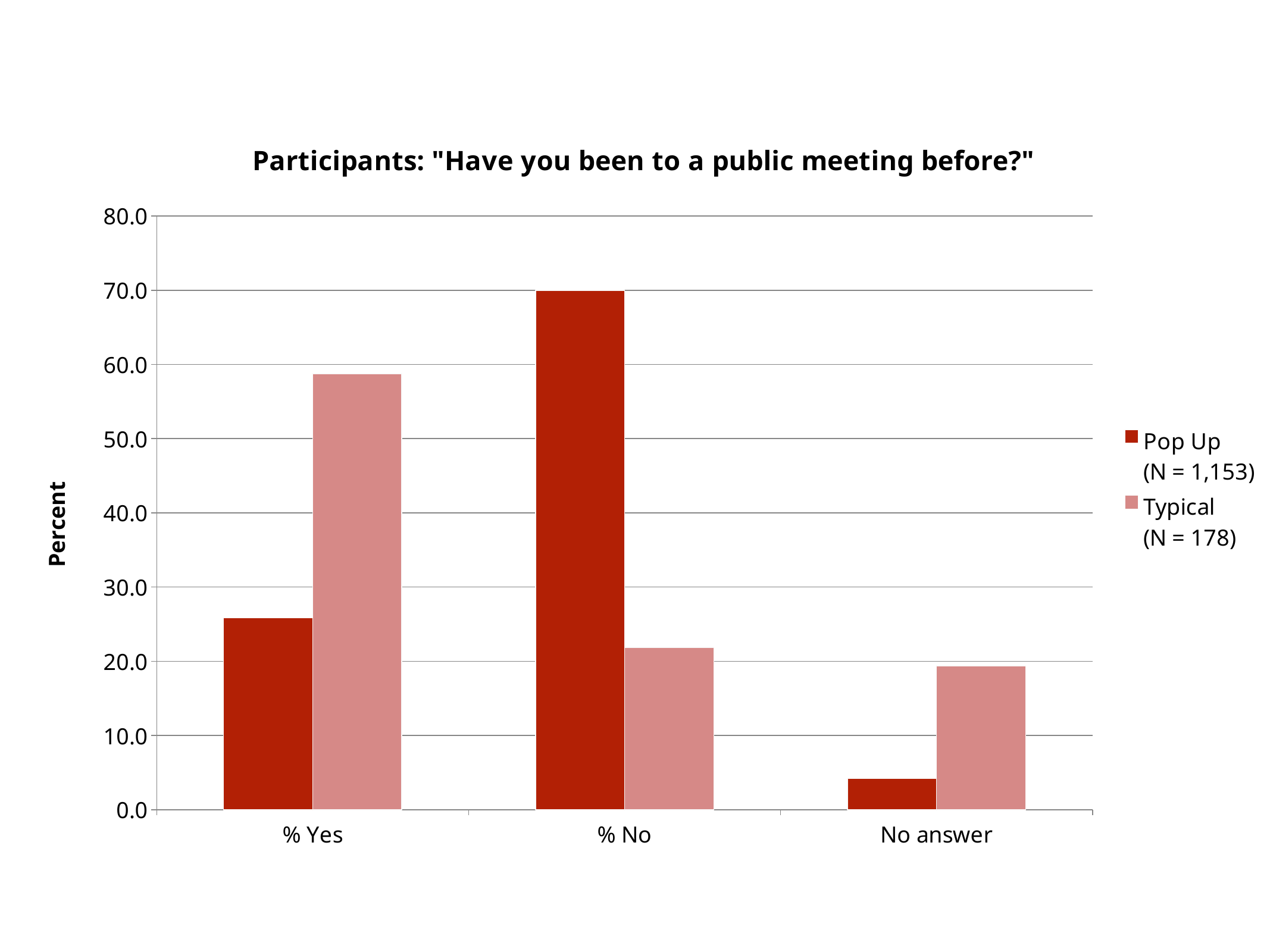
Which category has the highest value for the Pop Up (N = 1,153) series? % No For % No, which series has the larger value, Pop Up (N = 1,153) or Typical (N = 178)? Pop Up (N = 1,153) Which category has the lowest value for the Typical (N = 178) series? No answer How many series does the legend list? 2 How many categories are shown on the x axis? 3 Is the Pop Up (N = 1,153) value for % No greater or less than 60.0? greater For % Yes, which series has the larger value, Pop Up (N = 1,153) or Typical (N = 178)? Typical (N = 178) What kind of chart is shown on the slide? bar chart Which category has the highest value for the Typical (N = 178) series? % Yes What is the label on the vertical axis? Percent Which category has the lowest value for the Pop Up (N = 1,153) series? No answer